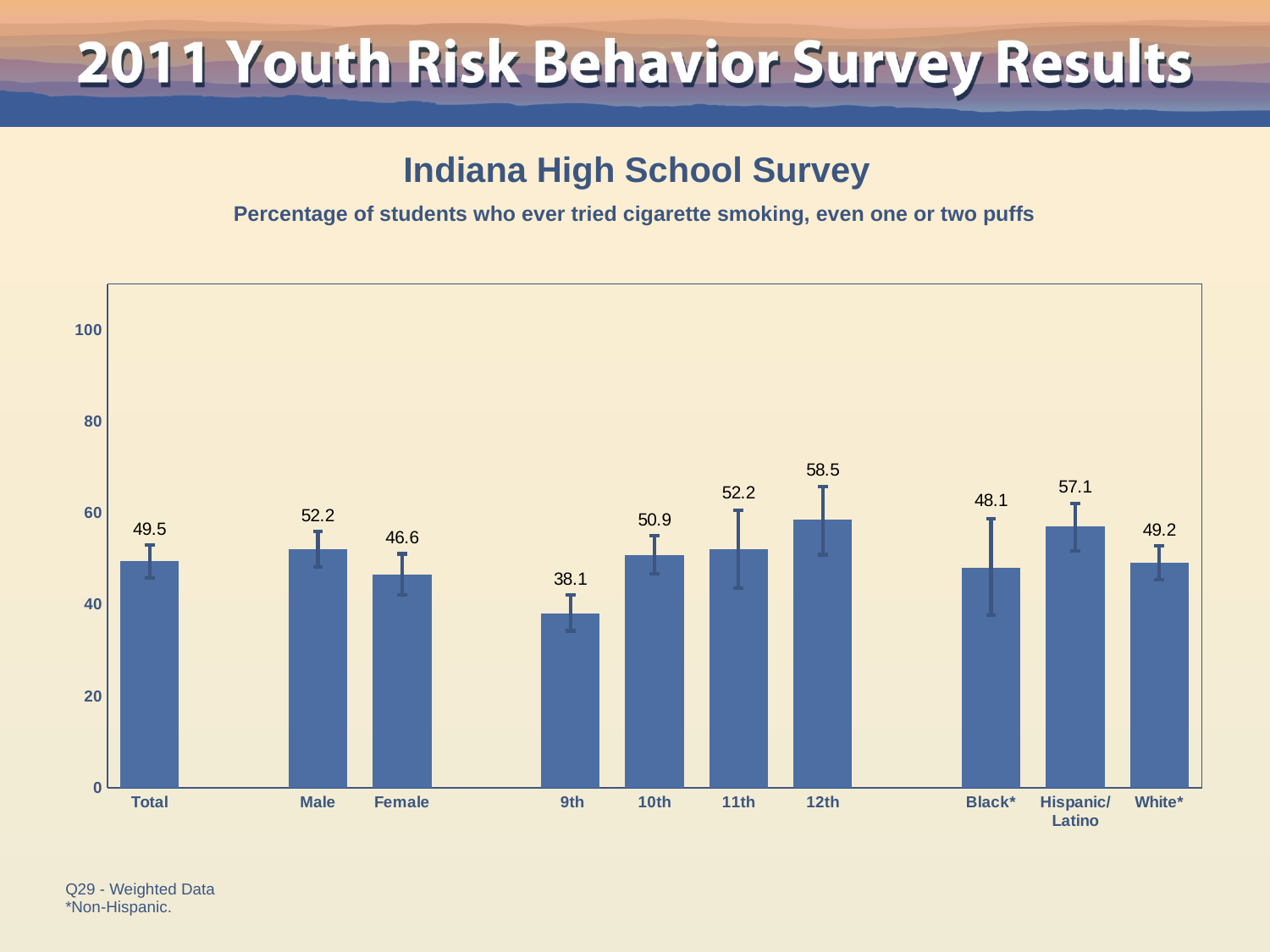
What is the value for 9th grade? 38.1 Which category has the lowest value? 9th What is the value for Hispanic/Latino? 57.1 Which is larger, the value for Black* or the value for White*? White* What kind of chart is this? bar chart What is the value for Total? 49.5 How many categories are shown on the x axis? 10 What is the difference between the 12th and 9th grade values? 20.4 Is the value for 11th grade greater or less than 40? greater Do the values rise or fall from 9th grade to 12th grade? rise What is the difference between the Male and Female values? 5.6 Which category has the highest value? 12th